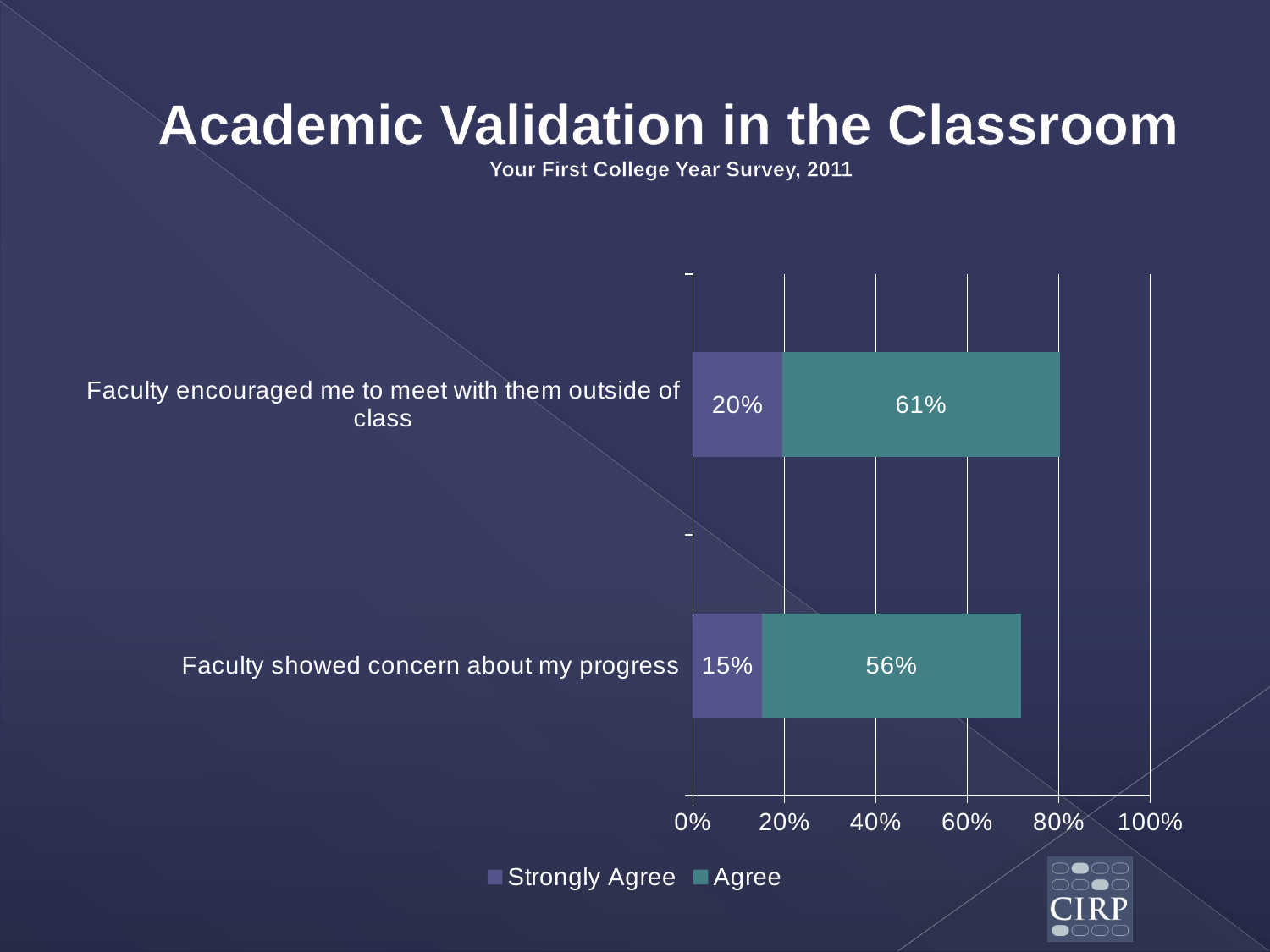
How many statements (categories) are shown in the chart? 2 What is the difference between the 'Agree' values for the two statements? 5% Which statement has the higher 'Strongly Agree' percentage? Faculty encouraged me to meet with them outside of class What is the 'Agree' value for 'Faculty encouraged me to meet with them outside of class'? 61% What percentage of students strongly agreed that faculty encouraged them to meet with them outside of class? 20% What kind of chart is shown on the slide? Stacked bar chart What is the combined total of 'Strongly Agree' and 'Agree' for 'Faculty encouraged me to meet with them outside of class'? 81% How many series does the legend list? 2 What is the combined total of 'Strongly Agree' and 'Agree' for 'Faculty showed concern about my progress'? 71% What is the 'Strongly Agree' value for 'Faculty showed concern about my progress'? 15% What percentage of students agreed that faculty showed concern about their progress? 56% Which statement has the lowest 'Agree' percentage? Faculty showed concern about my progress